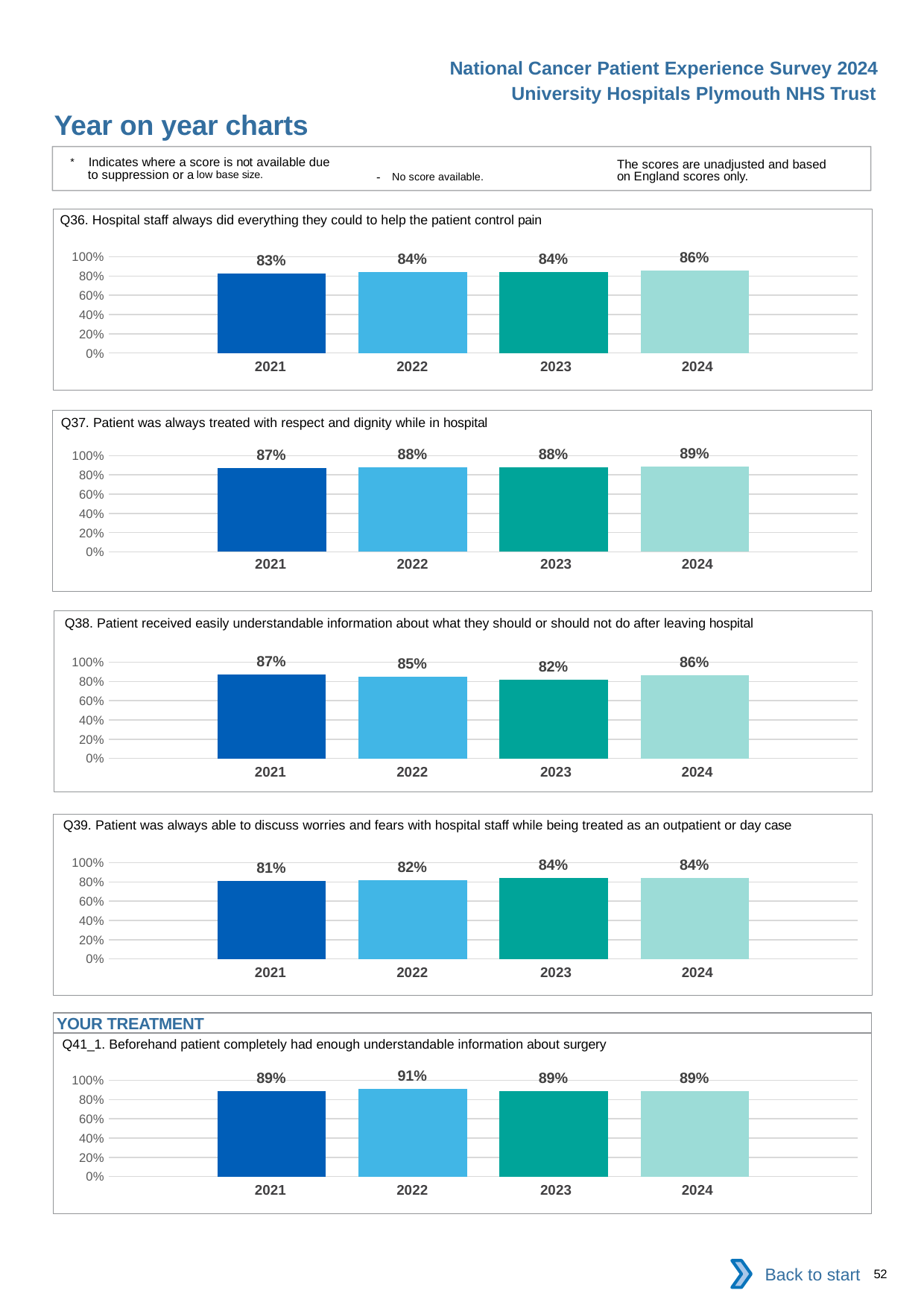
In the Q39 chart, which is larger, the value for 2021 or the value for 2023? 2023 In the Q39 chart, do the values rise or fall from 2021 to 2023? Rise In the Q36 chart, what is the value for 2024? 86% In the Q38 chart, which year has the lowest value? 2023 What kind of chart is the Q37 chart? Bar chart In the Q36 chart, is the value for 2021 greater or less than 60%? greater In the Q41_1 chart, what is the value for 2022? 91% In the Q37 chart, which year has the highest value? 2024 In the Q41_1 chart, which year has the highest value? 2022 How many bars are in the Q36 chart? 4 How many charts are shown on the slide? 5 In the Q38 chart, what is the difference between the 2021 value and the 2023 value? 5%